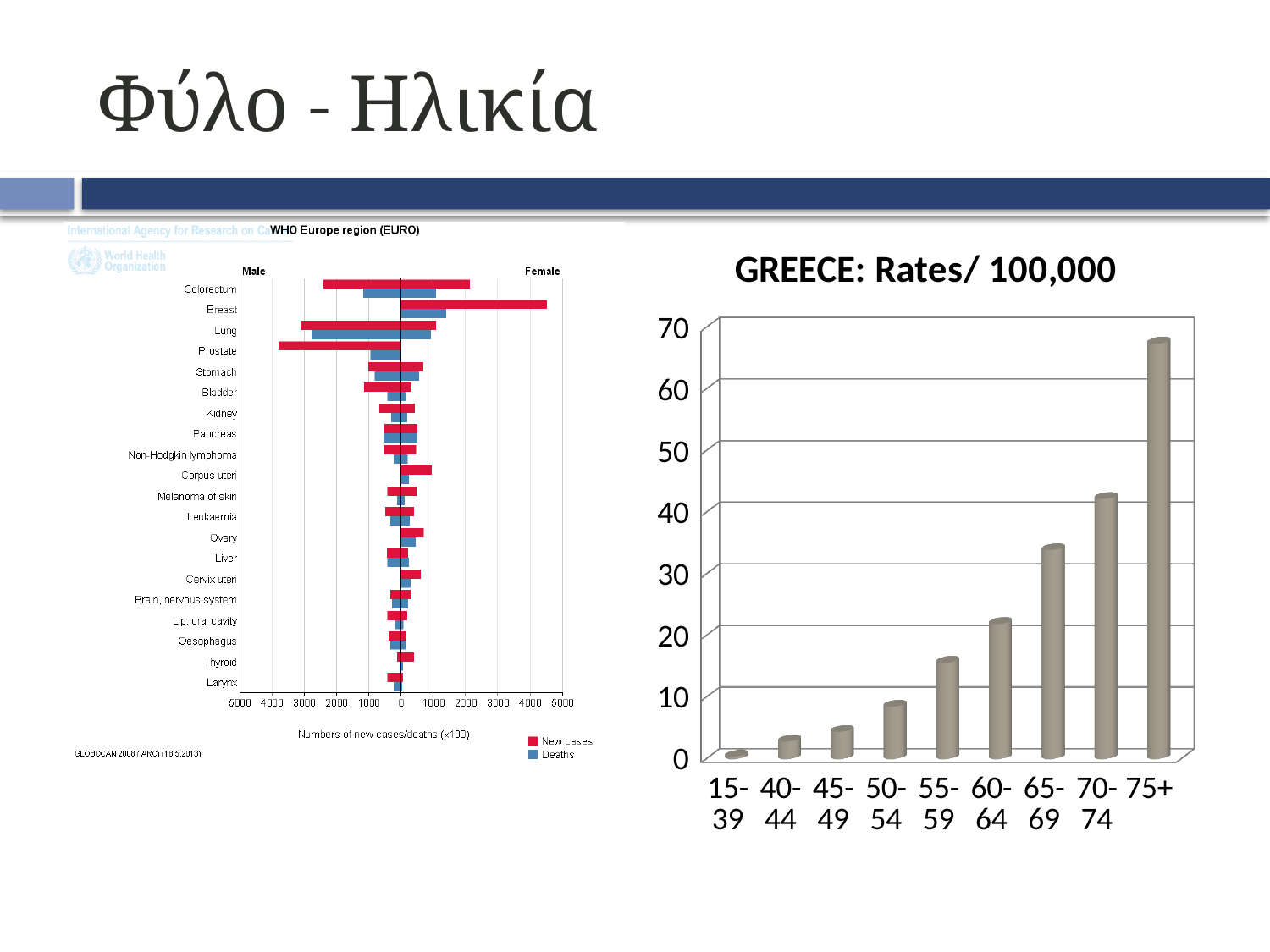
On the WHO Europe region (EURO) chart on the left, which cancer site has the highest number of new cases among males? Prostate On the GREECE: Rates/ 100,000 chart, how many age groups are shown? 9 On the GREECE: Rates/ 100,000 chart, which age group has the lowest rate? 15-39 On the GREECE: Rates/ 100,000 chart, is the value for the 70-74 age group greater or less than 40? greater On the GREECE: Rates/ 100,000 chart, do the rates rise or fall as age increases along the x axis? rise On the GREECE: Rates/ 100,000 chart, is the value for the 75+ age group greater or less than 60? greater On the WHO Europe region (EURO) chart on the left, how many series does the legend list? 2 On the WHO Europe region (EURO) chart on the left, is the number of new breast cancer cases among females greater or less than 4000 (x100)? greater On the GREECE: Rates/ 100,000 chart, which age group has the highest rate? 75+ On the WHO Europe region (EURO) chart on the left, which cancer site has the highest number of new cases among females? Breast What kind of chart is the GREECE: Rates/ 100,000 chart? bar chart